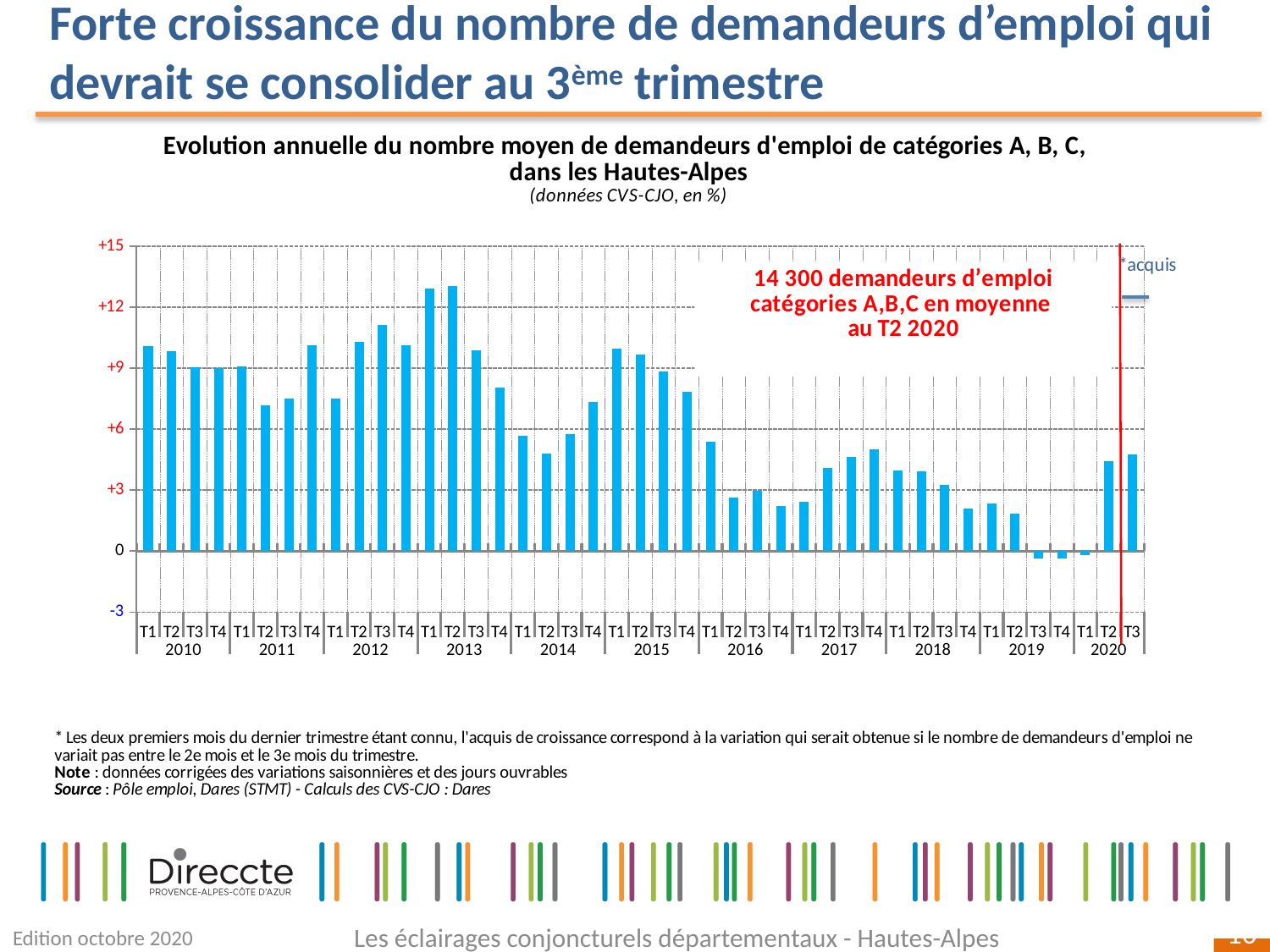
Is the value for T3 2019 greater or less than 0? less How many quarterly bars are plotted in the chart, from T1 2010 to T3 2020? 43 Do the values generally rise or fall from T2 2013 to T1 2016? fall What kind of chart is shown on the slide? bar chart Is the value for T1 2010 greater or less than +9? greater Is the value for T4 2016 greater or less than +3? less Which is larger, the value for T2 2013 or the value for T1 2016? T2 2013 In which year does the highest bar of the chart occur? 2013 According to the annotation on the chart, what was the average number of category A, B, C job seekers in T2 2020? 14 300